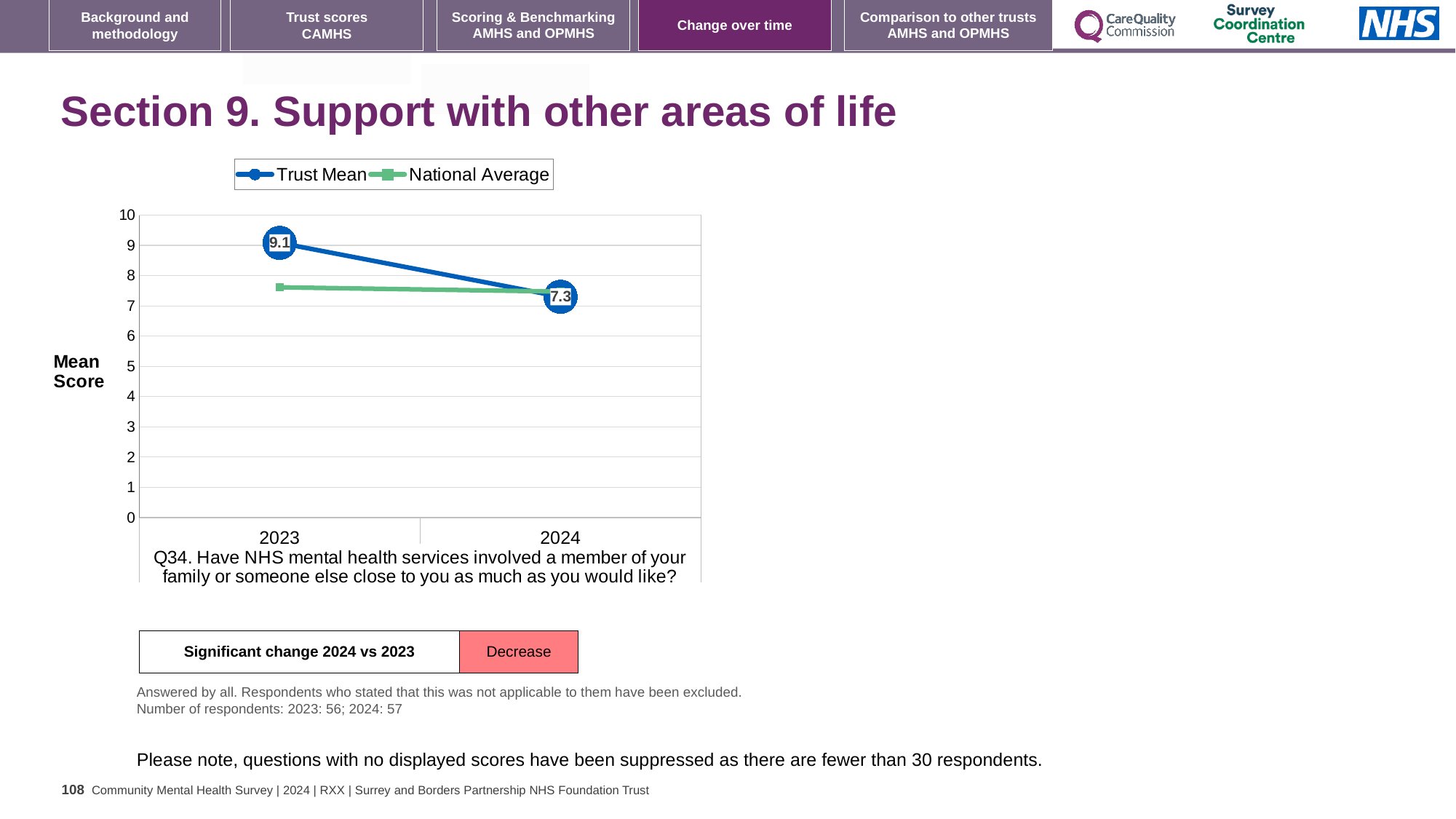
What is the Trust Mean value for 2023? 9.1 How many years are plotted on the x axis? 2 Is the National Average value for 2023 greater or less than 7? greater How many series does the legend list? 2 Which year has the higher Trust Mean, 2023 or 2024? 2023 In 2023, which is higher, the Trust Mean or the National Average? Trust Mean Is the National Average value for 2023 greater or less than 8? less By how much did the Trust Mean change from 2023 to 2024? 1.8 What is the label on the y axis of the chart? Mean Score Does the Trust Mean rise or fall from 2023 to 2024? fall What is the Trust Mean value for 2024? 7.3 What kind of chart is shown on the slide? line chart